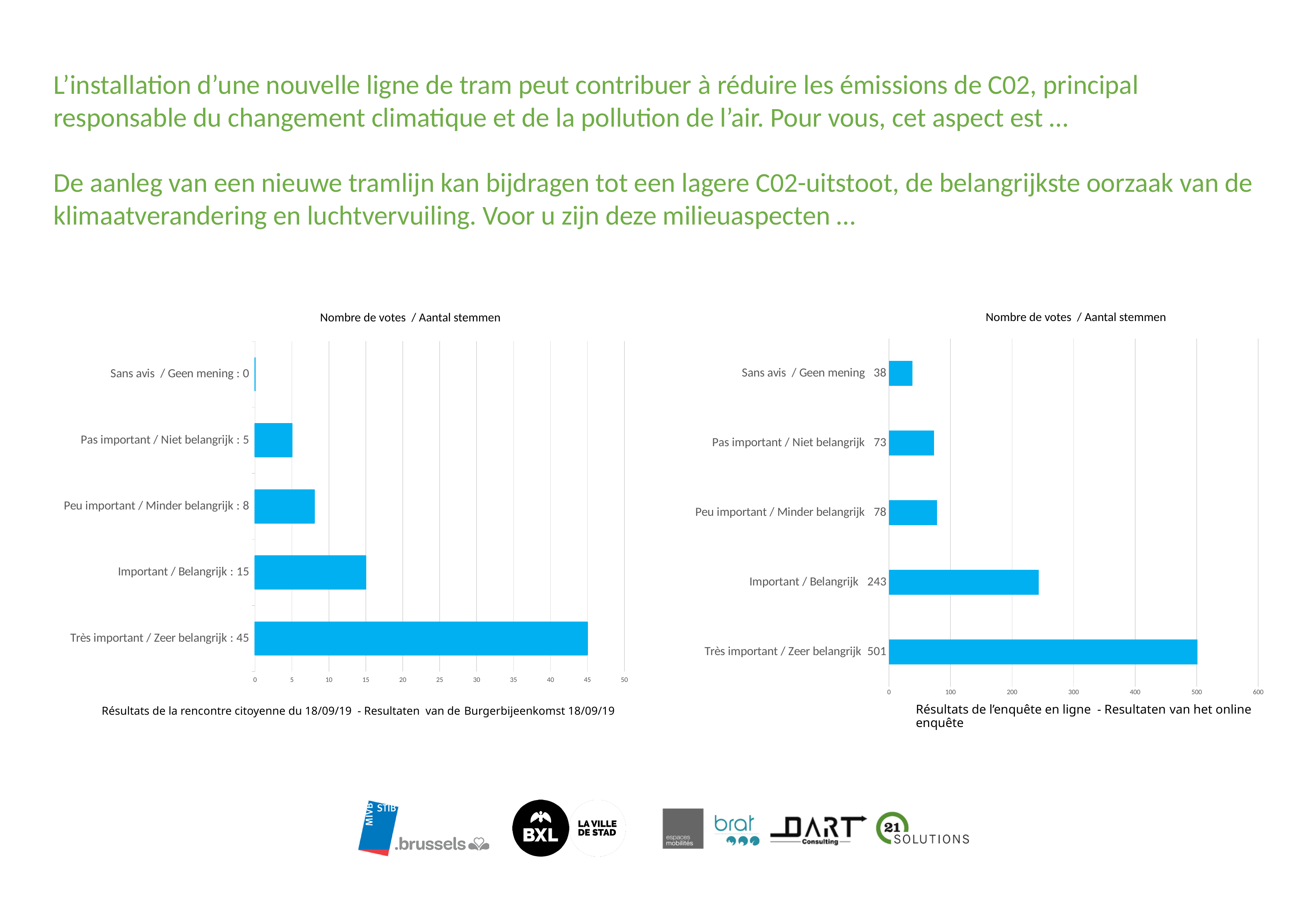
What type of chart is the right chart (Résultats de l'enquête en ligne)? Bar chart In the right chart (Résultats de l'enquête en ligne), which has more votes: 'Important / Belangrijk' or 'Pas important / Niet belangrijk'? Important / Belangrijk In the right chart (Résultats de l'enquête en ligne), how many votes did 'Sans avis / Geen mening' receive? 38 In the right chart (Résultats de l'enquête en ligne), how many votes did 'Important / Belangrijk' receive? 243 In the right chart (Résultats de l'enquête en ligne), what is the difference in votes between 'Peu important / Minder belangrijk' and 'Pas important / Niet belangrijk'? 5 In the left chart (Résultats de la rencontre citoyenne du 18/09/19), how many votes did 'Très important / Zeer belangrijk' receive? 45 What is the title shown above the left chart? Nombre de votes / Aantal stemmen In the left chart (Résultats de la rencontre citoyenne du 18/09/19), what is the difference in votes between 'Très important / Zeer belangrijk' and 'Important / Belangrijk'? 30 In the right chart (Résultats de l'enquête en ligne), which category has the highest number of votes? Très important / Zeer belangrijk In the right chart (Résultats de l'enquête en ligne), is the value for 'Très important / Zeer belangrijk' greater or less than 400? greater In the left chart (Résultats de la rencontre citoyenne du 18/09/19), which category has the lowest number of votes? Sans avis / Geen mening How many categories are shown in the left chart (Résultats de la rencontre citoyenne du 18/09/19)? 5